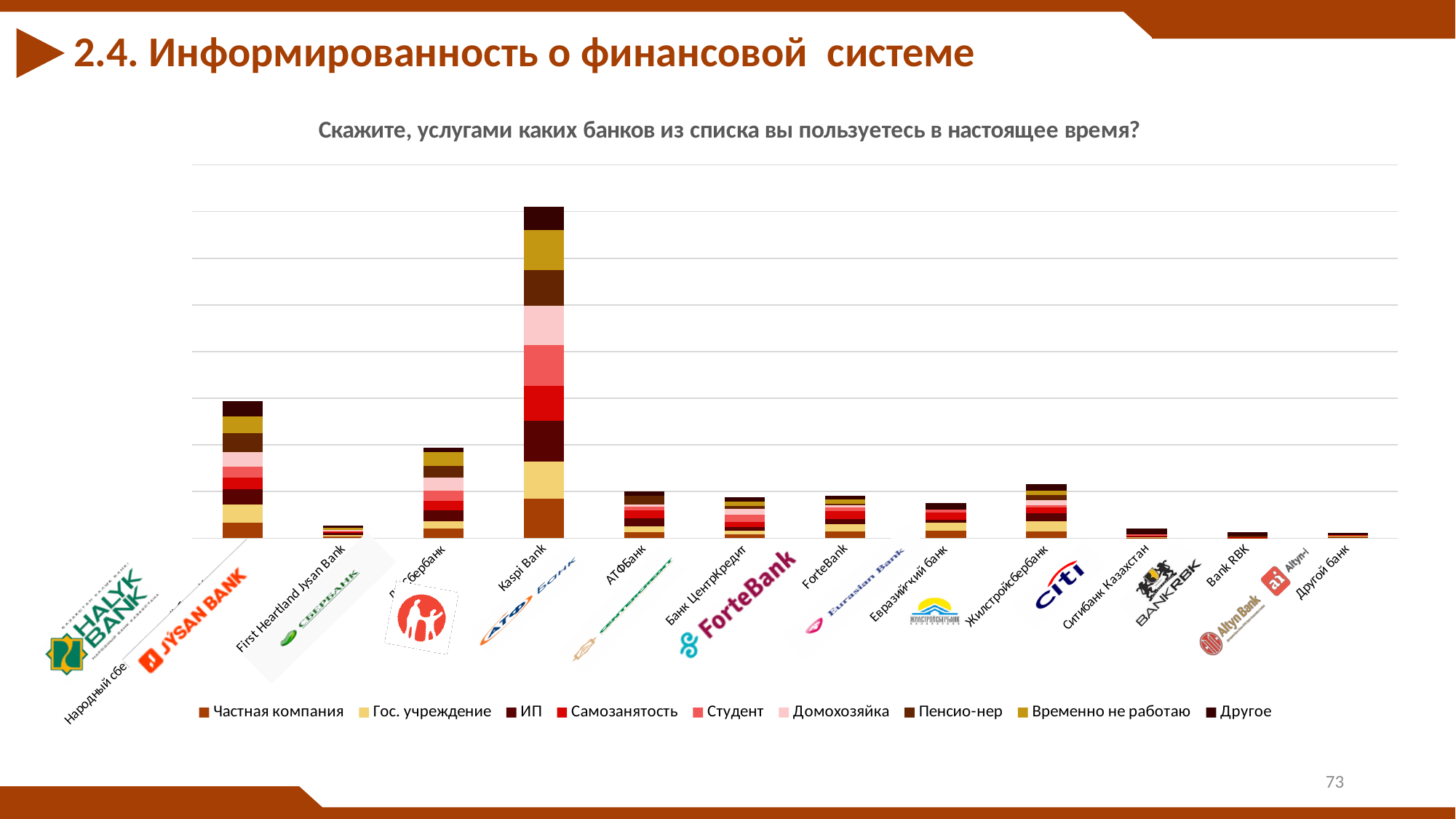
Which series is listed first in the legend? Частная компания How many series does the legend list? 9 How many bars (banks) are plotted in the chart? 12 Which bar is taller: Жилстройсбербанк or Ситибанк Казахстан? Жилстройсбербанк Which bar is taller: Kaspi Bank or ForteBank? Kaspi Bank What kind of chart is shown on the slide? Stacked bar chart Which bank has the tallest bar in the chart? Kaspi Bank Which bar is taller: Kaspi Bank or First Heartland Jysan Bank? Kaspi Bank What is the title of the chart? Скажите, услугами каких банков из списка вы пользуетесь в настоящее время?